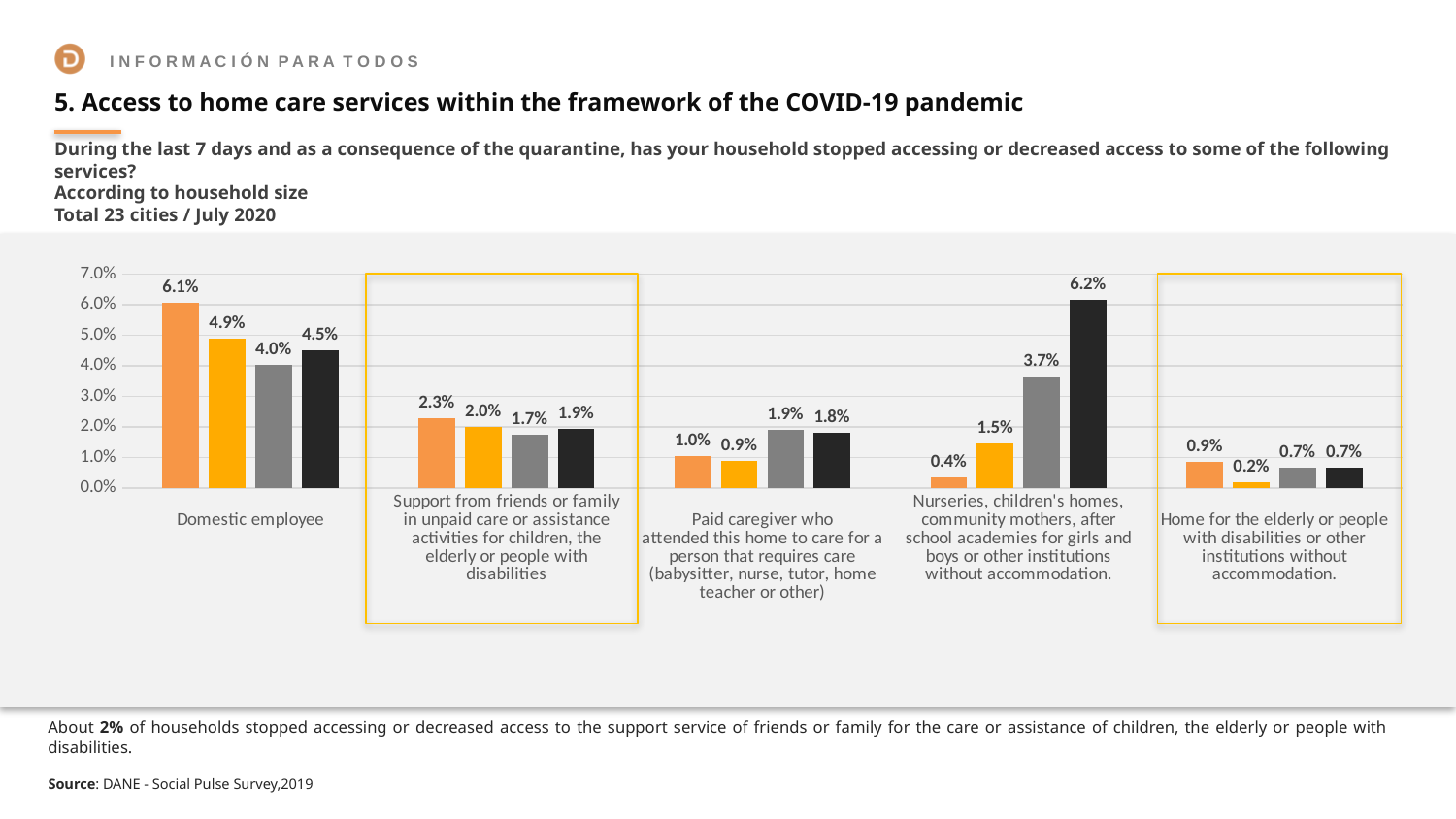
What is the value of the gray (third) bar for Paid caregiver who attended this home to care for a person that requires care? 1.9% Which bar has the highest value in the entire chart? The black (fourth) bar for Nurseries, children's homes, community mothers, after school academies for girls and boys or other institutions without accommodation, 6.2% Which bar has the lowest value in the entire chart? The yellow (second) bar for Home for the elderly or people with disabilities or other institutions without accommodation, 0.2% What is the value of the orange (first) bar for Domestic employee? 6.1% What is the maximum value shown on the y axis of the chart? 7.0% What is the difference between the black bar and the orange bar for Nurseries, children's homes, community mothers, after school academies for girls and boys or other institutions without accommodation? 5.8% What type of chart is shown on the slide? bar chart How many service categories are shown along the x axis of the chart? 5 Which is larger for Nurseries, children's homes, community mothers, after school academies: the orange bar or the gray bar? the gray bar What is the value of the yellow (second) bar for Home for the elderly or people with disabilities or other institutions without accommodation? 0.2% What is the difference between the orange bar and the gray bar for Domestic employee? 2.1% What is the value of the black (fourth) bar for Nurseries, children's homes, community mothers, after school academies for girls and boys or other institutions without accommodation? 6.2%